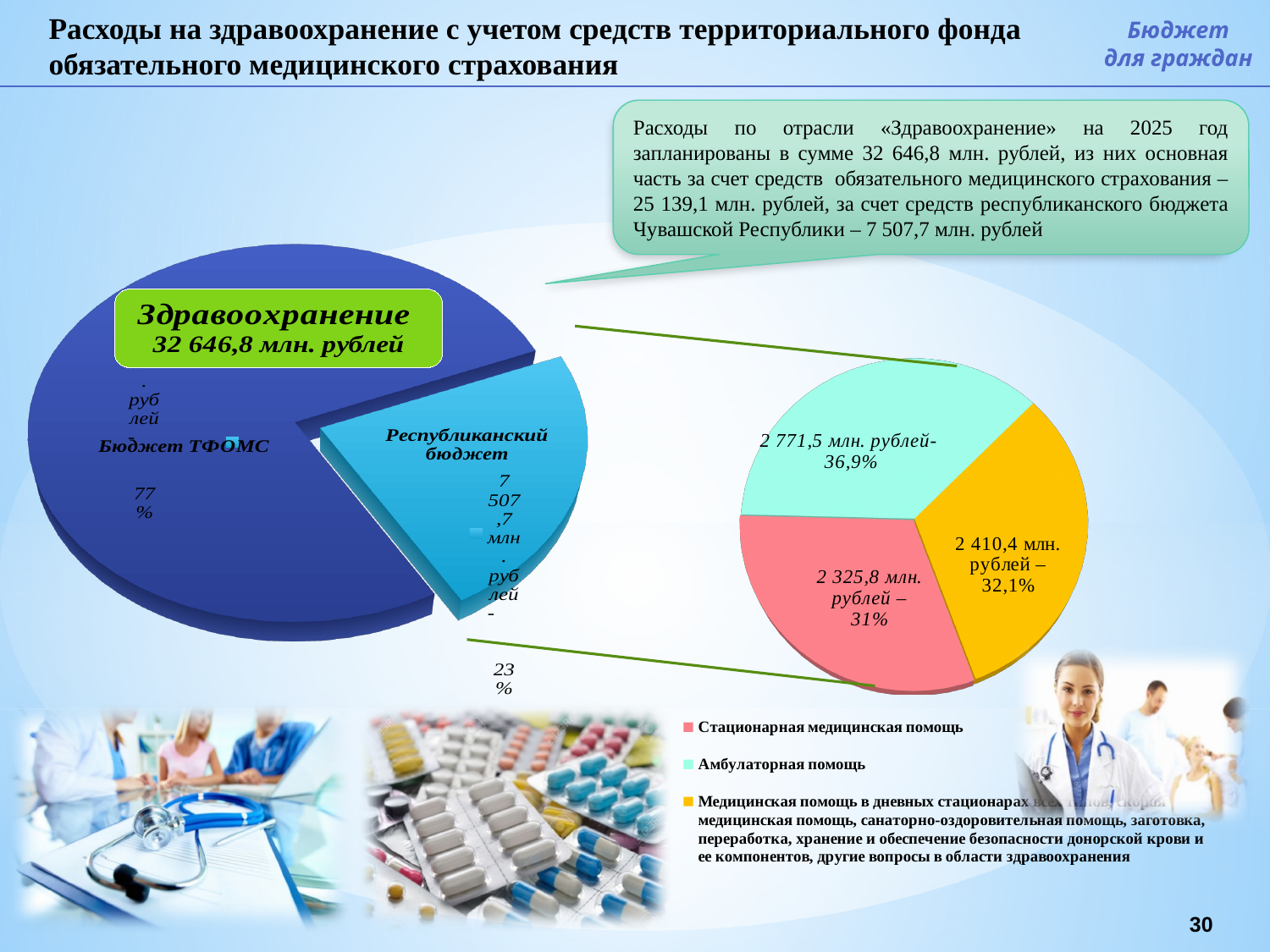
In the right pie chart, what share does Стационарная медицинская помощь have? 31% In the right pie chart, which category has the smallest share? Стационарная медицинская помощь In the left pie chart, what share does Бюджет ТФОМС have? 77% In the left pie chart, which slice is larger: Бюджет ТФОМС or Республиканский бюджет? Бюджет ТФОМС In the left pie chart, what value is shown for Республиканский бюджет? 7 507,7 млн. рублей In the right pie chart, what colour is the slice for Амбулаторная помощь? Light cyan In the left pie chart, what share does Республиканский бюджет have? 23% What kind of chart is the left chart on the slide? Pie chart In the right pie chart, what value is shown for Амбулаторная помощь? 2 771,5 млн. рублей What kind of chart is the right chart on the slide? Pie chart How many slices does the right pie chart have? 3 In the right pie chart, which category has the largest share? Амбулаторная помощь